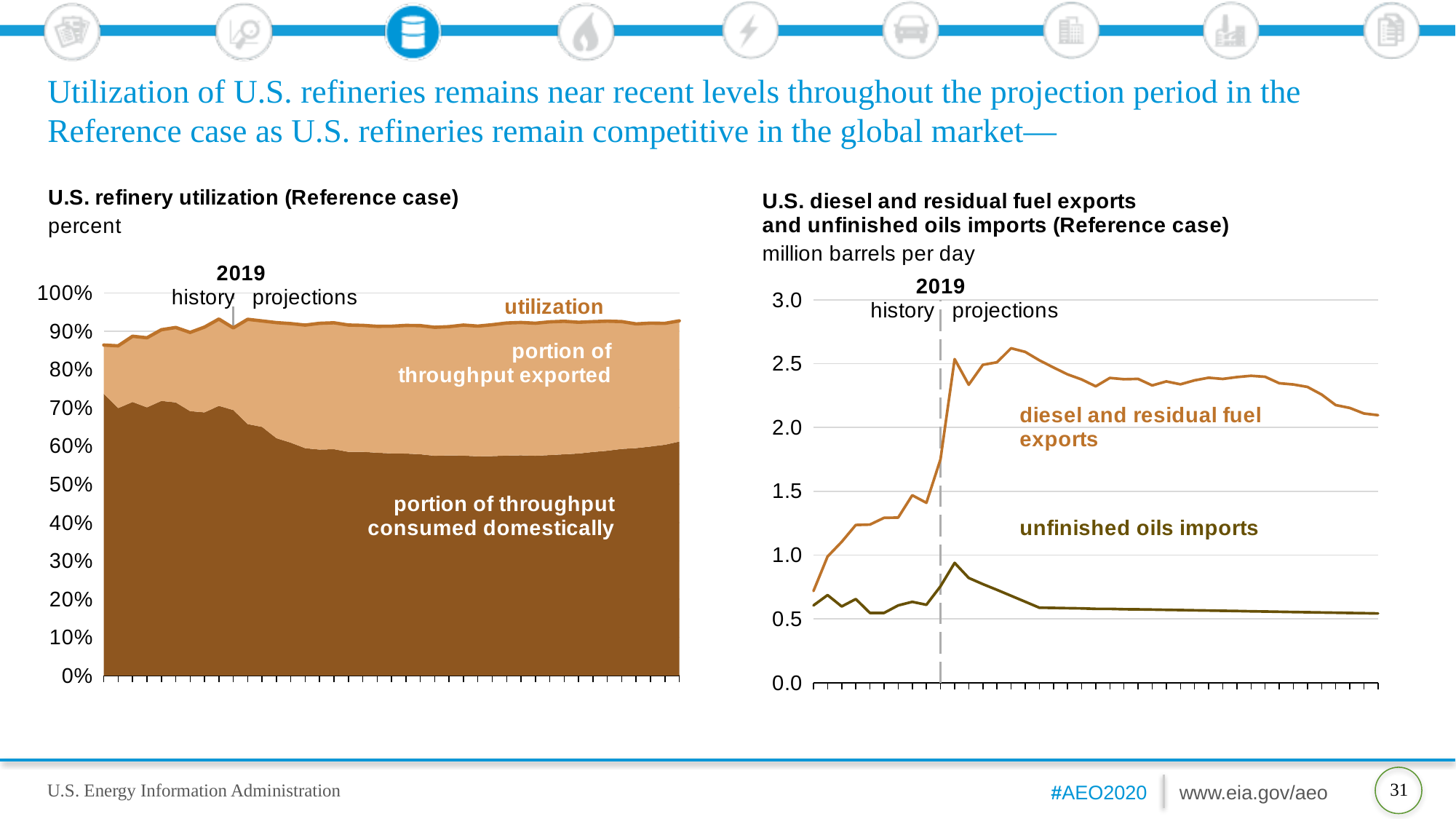
In the right chart, is the peak value of diesel and residual fuel exports greater or less than 2.5? greater In the right chart, is the value of unfinished oils imports at the end of the projection period greater or less than 1.0? less In the left chart, is the portion of throughput consumed domestically at the end of the projection period greater or less than 70%? less In the right chart, which series is higher throughout the projection period: diesel and residual fuel exports or unfinished oils imports? diesel and residual fuel exports In the left chart, does the portion of throughput consumed domestically rise or fall over the history period? fall In the right chart, how many series are plotted? 2 In the right chart, what unit are the values measured in? million barrels per day In the right chart, do unfinished oils imports rise or fall over the projection period? fall What kind of chart is the left chart, 'U.S. refinery utilization (Reference case)'? area chart In the left chart, which year marks the boundary between history and projections? 2019 What kind of chart is the right chart, 'U.S. diesel and residual fuel exports and unfinished oils imports (Reference case)'? line chart